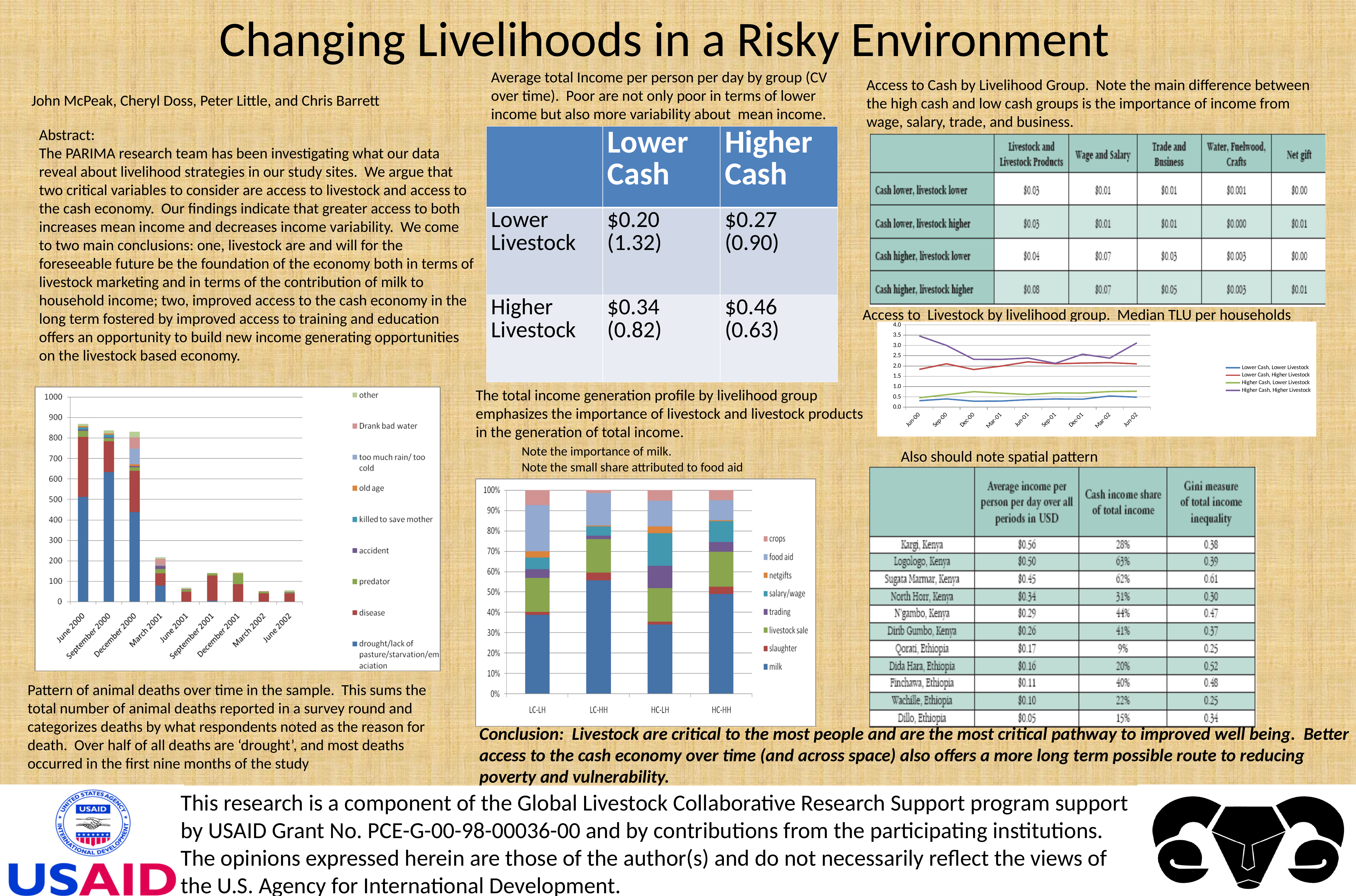
In the animal deaths chart at the bottom left, how many causes of death does the legend list? 9 In the median TLU line chart on the right, how many series does the legend list? 4 In the median TLU line chart on the right, which group has the highest median TLU at Jun-00? Higher Cash, Higher Livestock In the income generation profile chart at the bottom middle, which group has the largest share of income from milk? LC-HH In the income generation profile chart at the bottom middle, how many income sources does the legend list? 8 In the income generation profile chart at the bottom middle, is the milk share for LC-HH greater or less than 50%? greater In the animal deaths chart at the bottom left, do total deaths generally rise or fall from June 2000 to June 2002? fall In the animal deaths chart at the bottom left, is the total number of deaths for June 2000 greater or less than 800? greater In the income generation profile chart at the bottom middle, how many livelihood groups are shown on the x axis? 4 In the animal deaths chart at the bottom left, is the total number of deaths for March 2001 greater or less than 300? less In the animal deaths chart at the bottom left, how many survey rounds are shown on the x axis? 9 In the animal deaths chart at the bottom left, what kind of chart is it? stacked bar chart